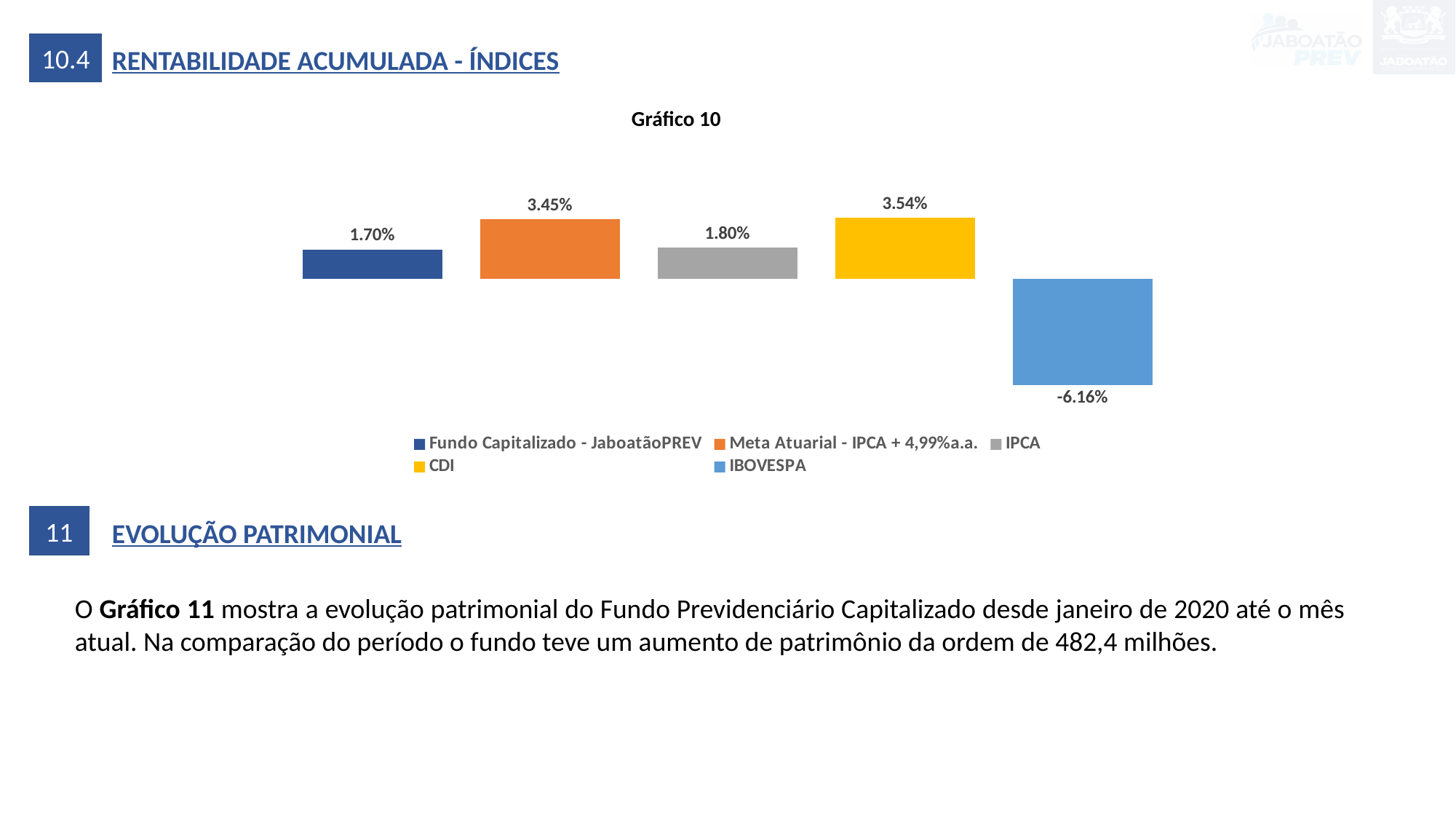
What is the difference between the Meta Atuarial - IPCA + 4,99%a.a. value and the Fundo Capitalizado - JaboatãoPREV value in Gráfico 10? 1.75% What kind of chart is Gráfico 10? Bar chart What is the difference between the CDI value and the Meta Atuarial - IPCA + 4,99%a.a. value in Gráfico 10? 0.09% Which series has the lowest value in Gráfico 10? IBOVESPA What is the value for Meta Atuarial - IPCA + 4,99%a.a. in Gráfico 10? 3.45% Which is larger in Gráfico 10, the value for IPCA or the value for Fundo Capitalizado - JaboatãoPREV? IPCA What is the value for IPCA in Gráfico 10? 1.80% Which series has the highest value in Gráfico 10? CDI What is the value for Fundo Capitalizado - JaboatãoPREV in Gráfico 10? 1.70% How many series does the legend of Gráfico 10 list? 5 What is the value for CDI in Gráfico 10? 3.54% What is the value for IBOVESPA in Gráfico 10? -6.16%